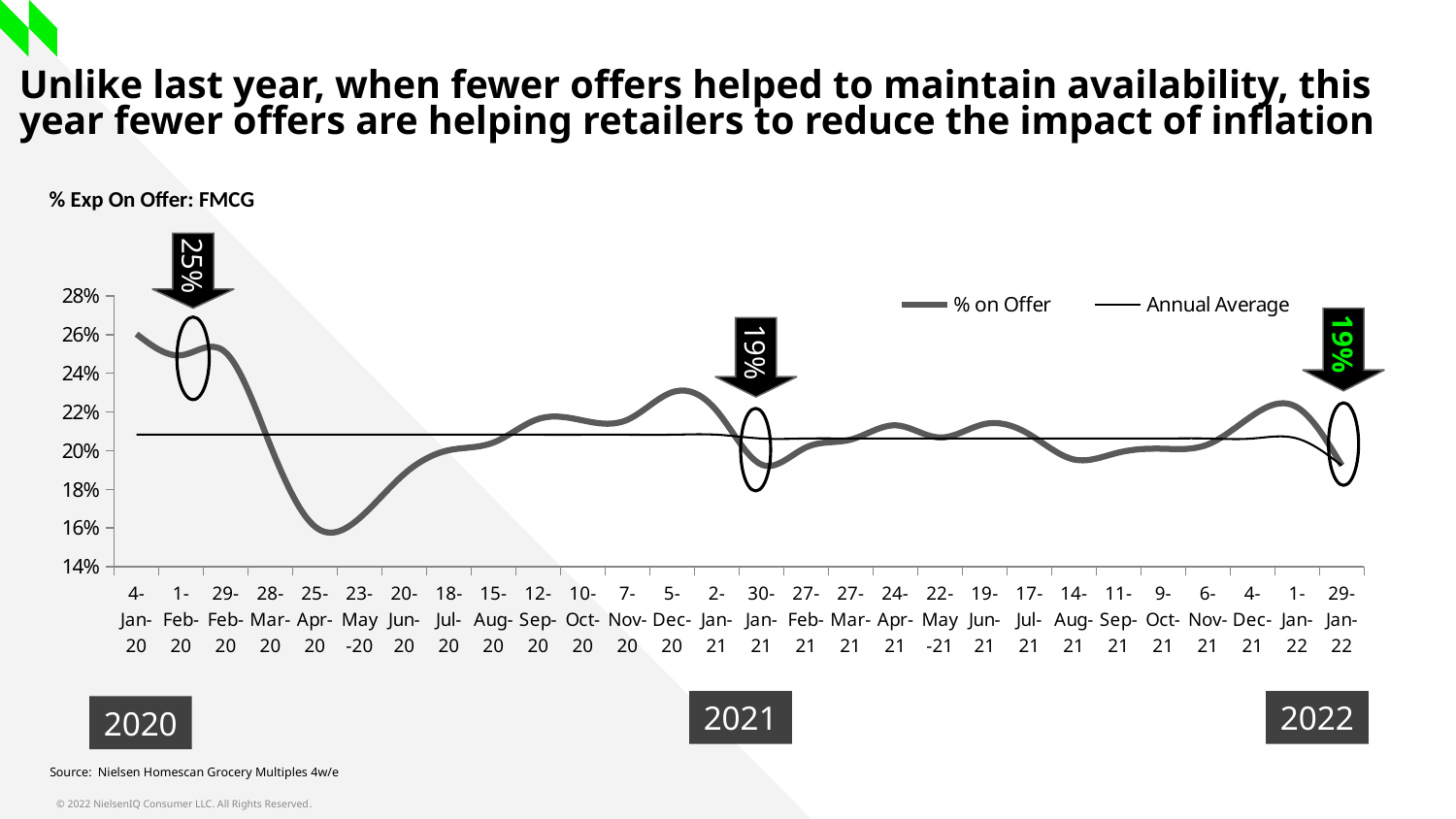
What value is annotated for % on Offer at 29-Jan-22? 19% What are the two series named in the chart legend? % on Offer and Annual Average Is the % on Offer value at 25-Apr-20 greater or less than 18%? less What is the difference between the annotated % on Offer values at 29-Feb-20 and 30-Jan-21? 6 percentage points How many series does the chart legend list? 2 What value is annotated for % on Offer at 30-Jan-21? 19% What is the title of the chart? % Exp On Offer: FMCG Which is larger, the annotated % on Offer at 29-Feb-20 or at 29-Jan-22? 29-Feb-20 How many date labels are shown on the x axis? 28 Is the % on Offer value at 4-Jan-20 greater or less than 24%? greater What kind of chart is shown on the slide? Line chart What value is annotated for % on Offer at 29-Feb-20? 25%